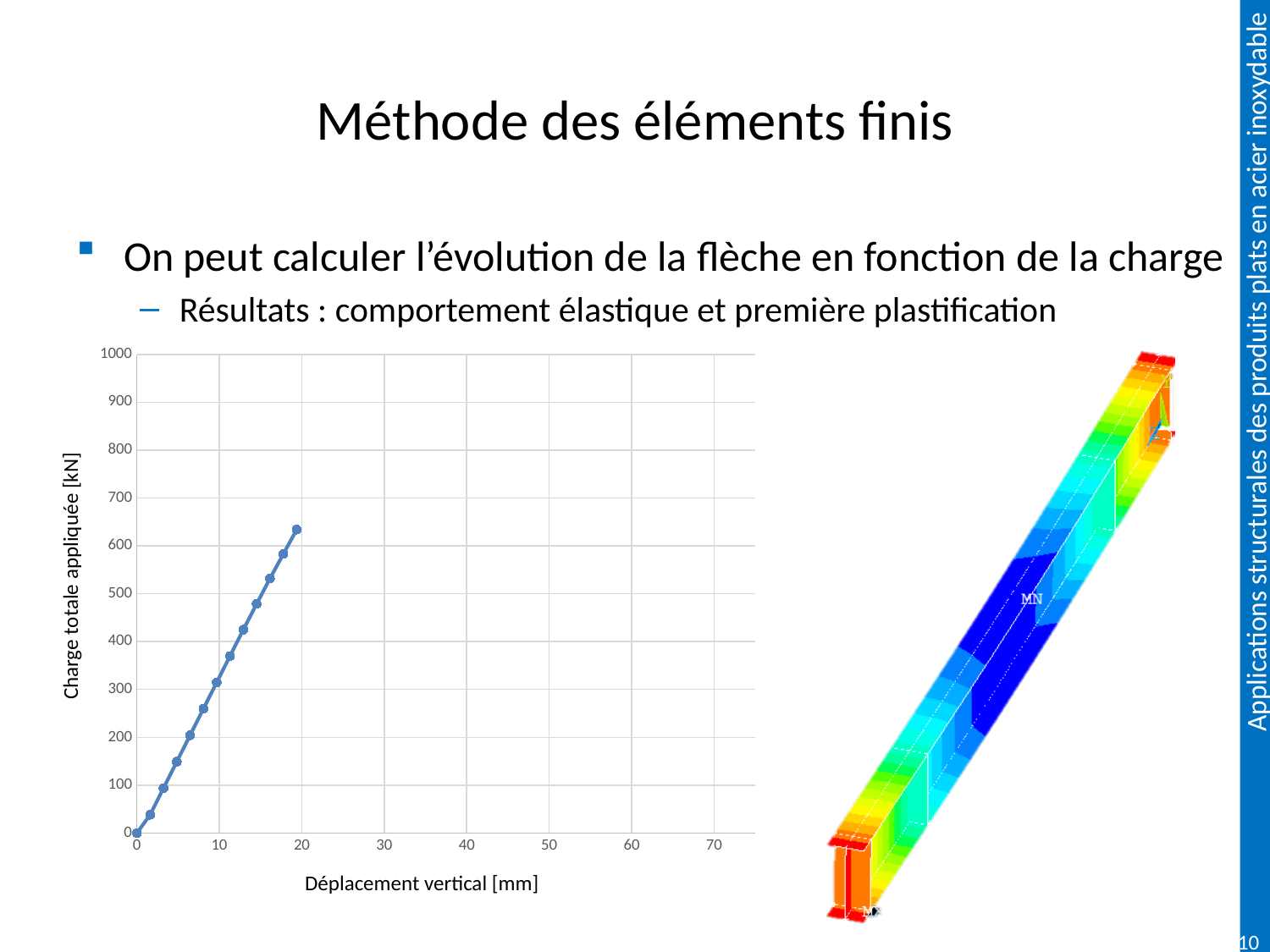
What is the applied load at the first plotted point of the curve? 0 What is the label of the vertical axis of the chart? Charge totale appliquée [kN] What is the maximum value shown on the vertical axis of the chart? 1000 Does the applied load rise or fall as the vertical displacement increases along the x axis? rise Is the largest vertical displacement plotted on the chart greater or less than 30 mm? less What is the label of the horizontal axis of the chart? Déplacement vertical [mm] Is the highest applied load plotted on the chart greater or less than 700 kN? less Is the highest applied load plotted on the chart greater or less than 600 kN? greater What kind of chart is shown on the slide? line chart